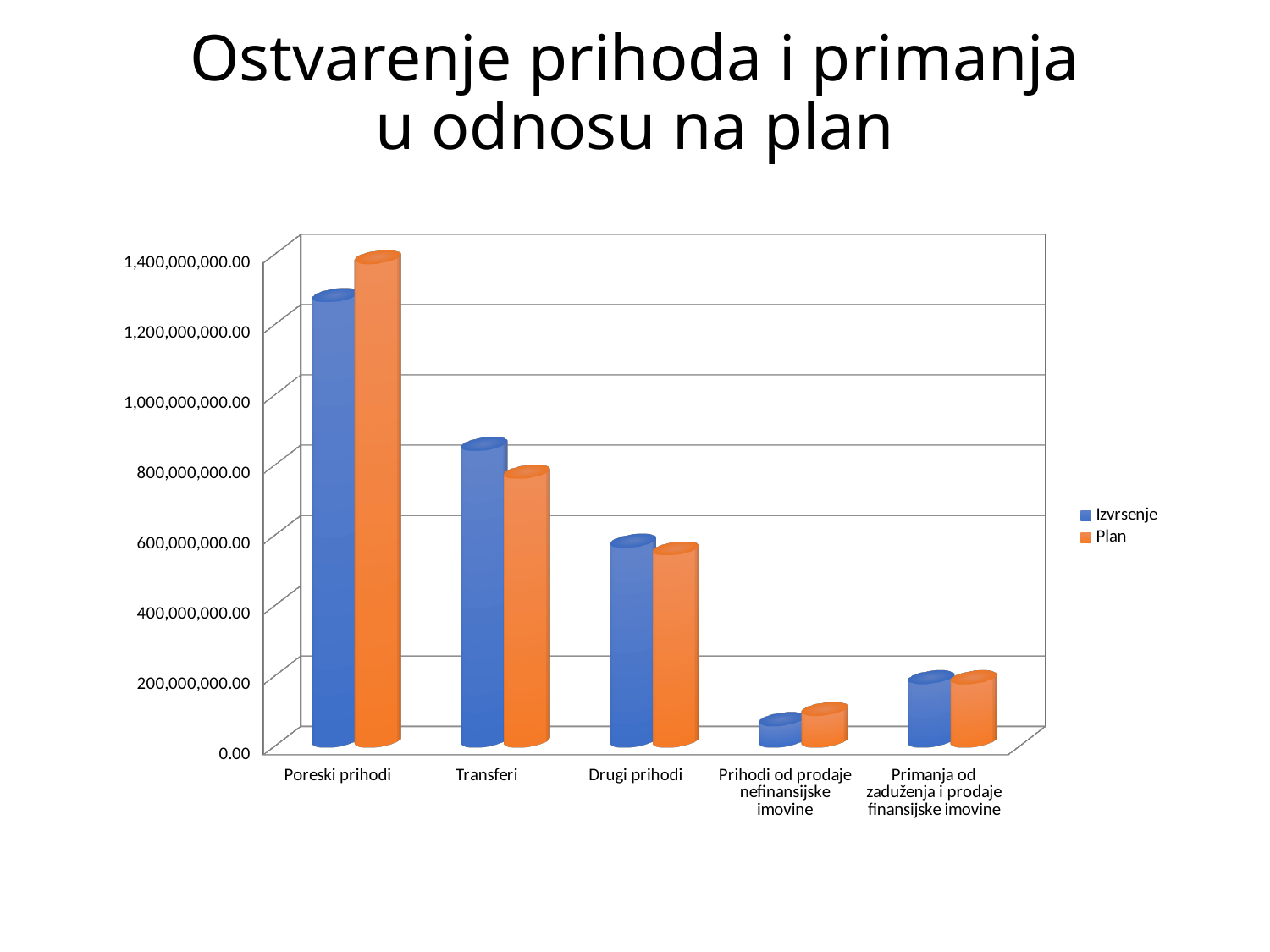
What is the title of the slide containing the chart? Ostvarenje prihoda i primanja u odnosu na plan Is the Plan value for Transferi greater or less than 800,000,000.00? less Is the Izvrsenje value for Poreski prihodi greater or less than 1,200,000,000.00? greater Which colour represents the Plan series in the chart? Orange Which category has the highest Izvrsenje value? Poreski prihodi How many categories are shown on the x axis? 5 Is the Plan value for Prihodi od prodaje nefinansijske imovine greater or less than 200,000,000.00? less How many series does the legend list? 2 What kind of chart is shown on the slide? Bar chart Which category has the lowest Plan value? Prihodi od prodaje nefinansijske imovine For Poreski prihodi, which is larger: Izvrsenje or Plan? Plan For Transferi, which is larger: Izvrsenje or Plan? Izvrsenje